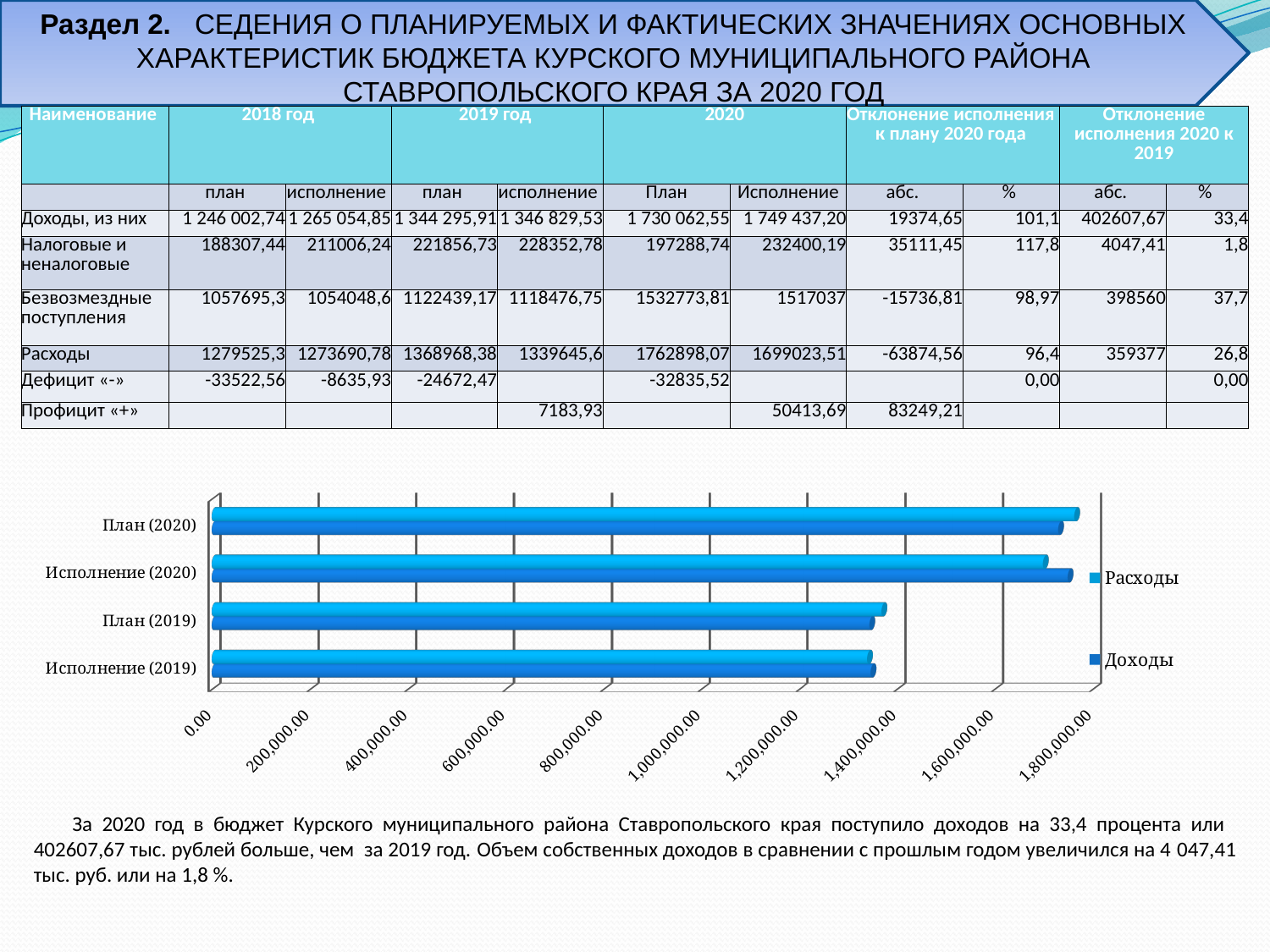
Is the Доходы value for Исполнение (2019) greater or less than 1,400,000.00? less Which category has the longest Доходы bar? Исполнение (2020) For Исполнение (2020), which is larger: Расходы or Доходы? Доходы What is the highest value shown on the chart's horizontal axis? 1,800,000.00 Is the Расходы value for План (2019) greater or less than 1,200,000.00? greater Which series are listed in the chart legend? Расходы, Доходы Which category has the longest Расходы bar? План (2020) Is the Расходы value for План (2020) greater or less than 1,600,000.00? greater How many series does the chart legend list? 2 What kind of chart is shown on the slide? bar chart How many categories are shown on the vertical axis of the chart? 4